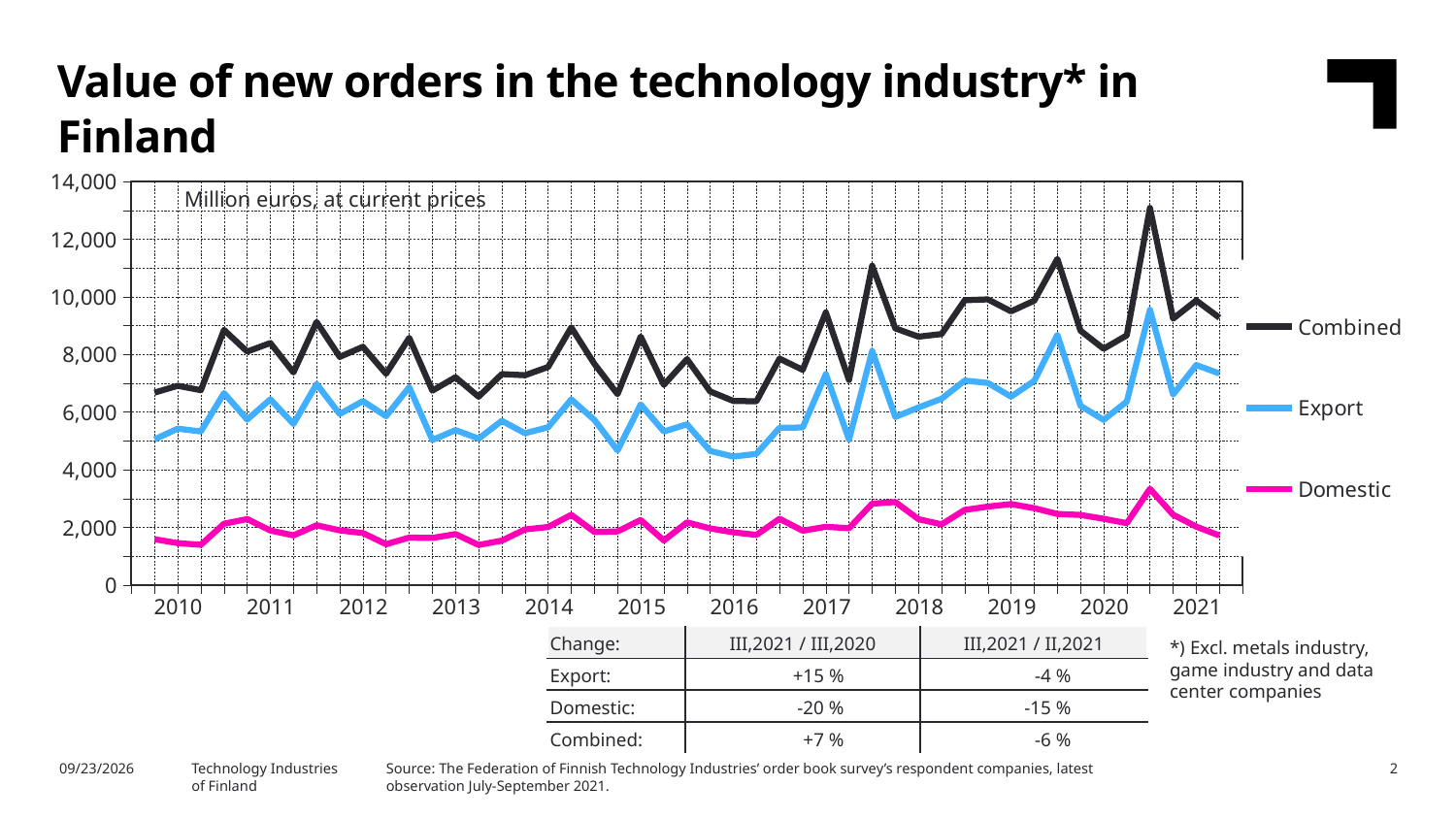
Is the lowest Export value in 2016 greater or less than 6,000? less Is the peak value of the Export series in 2020 greater or less than 8,000? greater What kind of chart is shown on the slide? Line chart Is the Domestic value at the start of 2010 greater or less than 4,000? less In 2019, which is larger, the Export value or the Domestic value? Export How many series does the legend list? 3 How many years are labelled on the x axis? 12 Which series has the lowest values throughout the chart? Domestic Which series has the highest values throughout the chart? Combined What unit is stated in the chart's subtitle? Million euros, at current prices What is the title of the chart? Value of new orders in the technology industry* in Finland